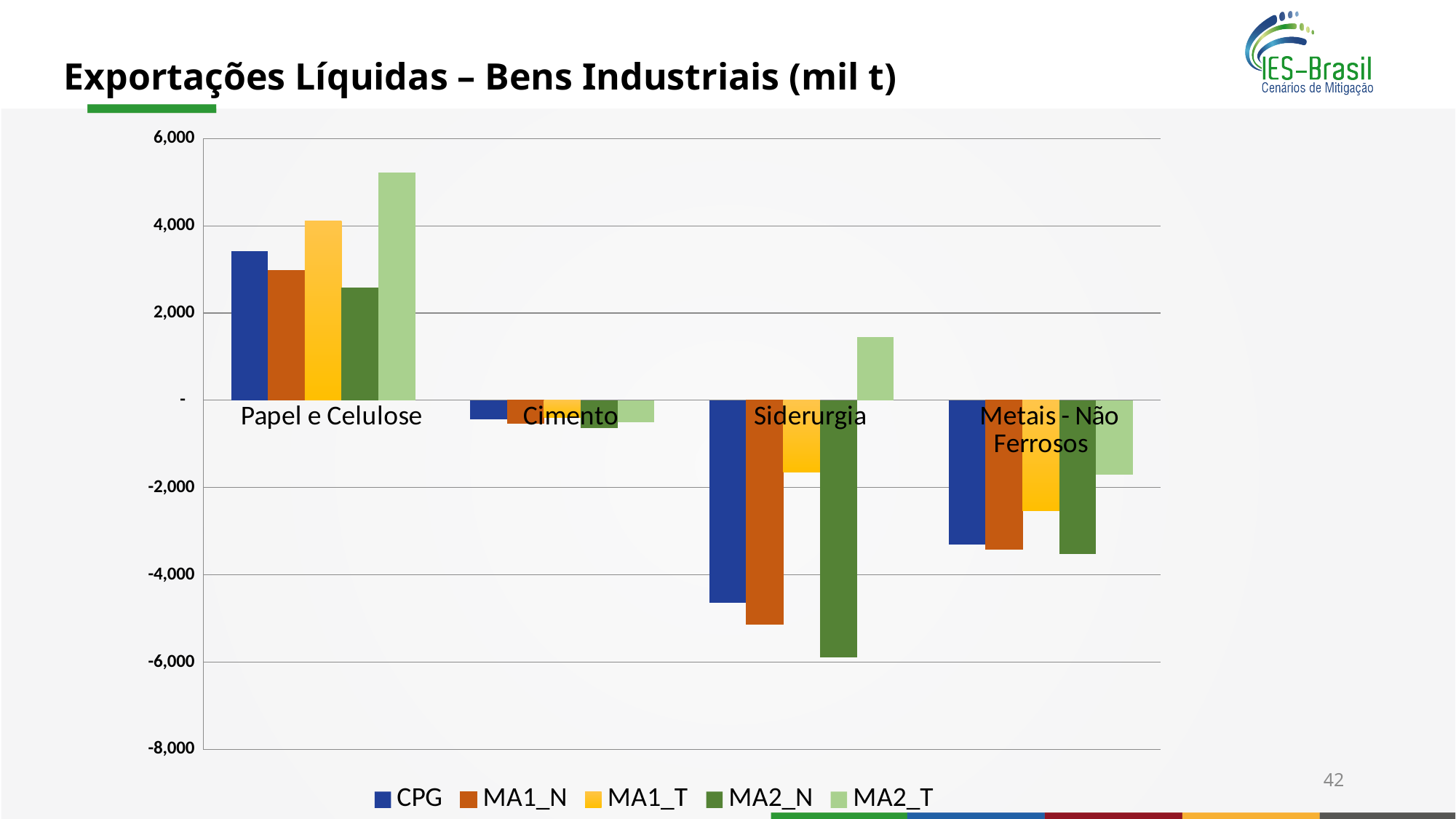
Is the MA2_T value for Papel e Celulose greater or less than 4,000? greater How many categories are shown on the x axis? 4 Which series has the lowest (most negative) value for Siderurgia? MA2_N Is the CPG value for Metais - Não Ferrosos greater or less than -2,000? less How many series does the legend list? 5 Is the MA2_N value for Siderurgia greater or less than -4,000? less Which series is the only one with a positive value for Siderurgia? MA2_T What kind of chart is shown on the slide? Bar chart Which series has the highest value for Papel e Celulose? MA2_T What is the title of the chart? Exportações Líquidas – Bens Industriais (mil t) For Papel e Celulose, which is larger: the MA1_T value or the CPG value? MA1_T